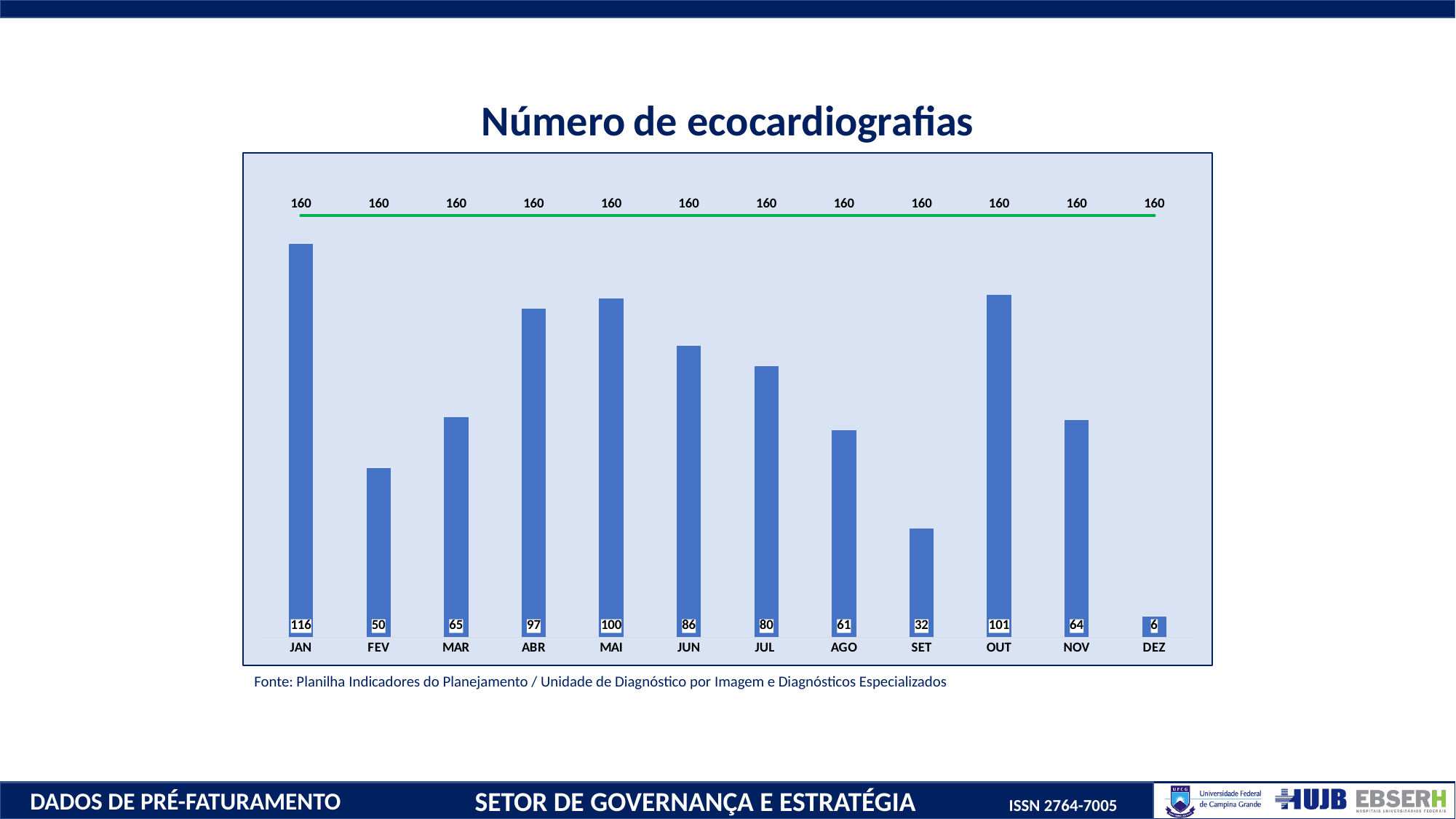
Which is larger, the value for ABR or the value for JUN? ABR What is the difference between the values for MAI and FEV? 50 What is the number of ecocardiografias for OUT? 101 What is the title of the chart? Número de ecocardiografias What type of chart is shown on the slide? bar chart What is the value of the green target line for each month? 160 How many months are shown on the x axis? 12 What is the number of ecocardiografias for SET? 32 Which month has the lowest number of ecocardiografias? DEZ What is the number of ecocardiografias for JAN? 116 Which month has the highest number of ecocardiografias? JAN Do the values rise or fall from OUT to DEZ? fall